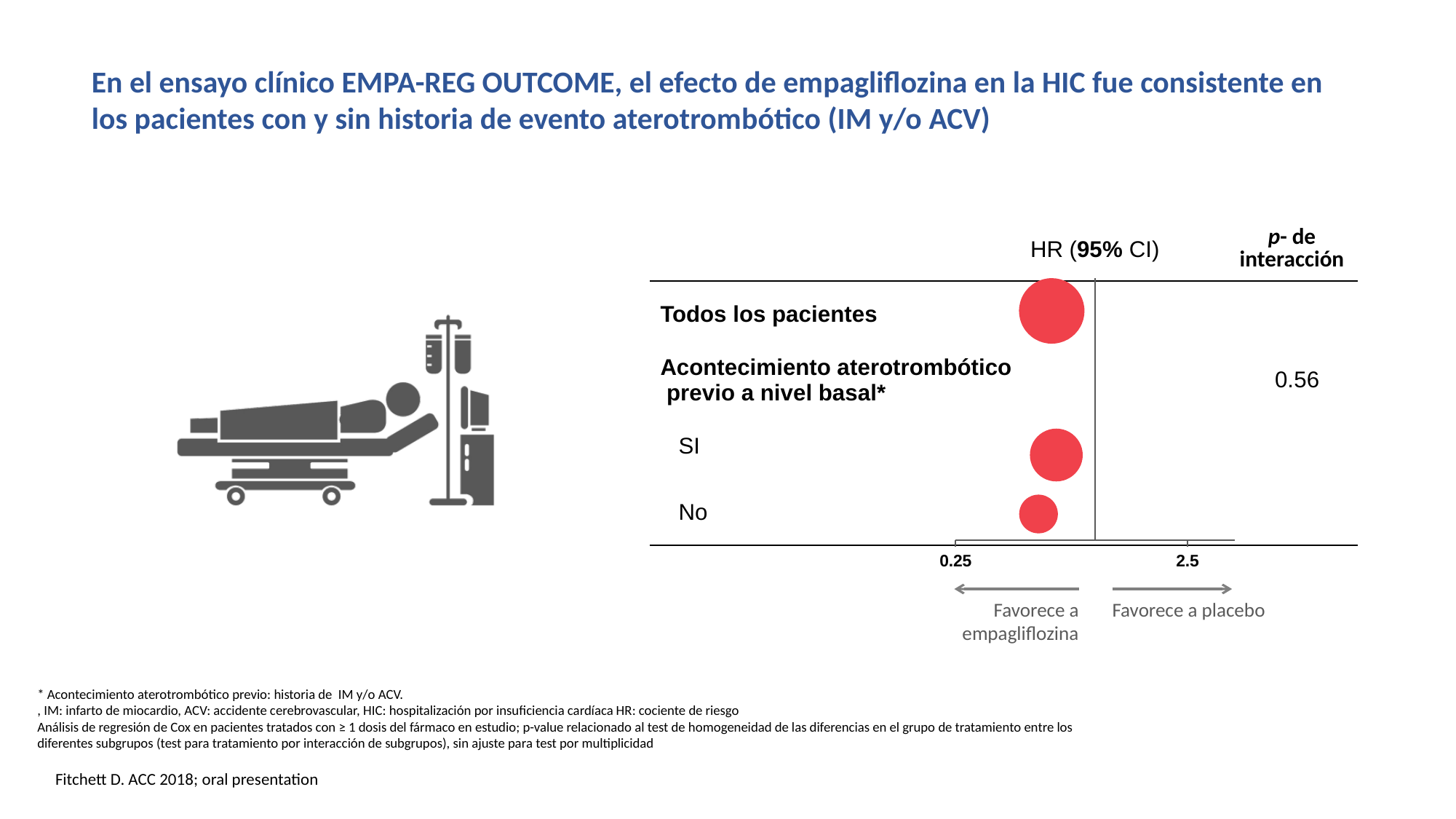
Which subgroup row has the smallest plotted marker? No What does the left side of the x axis favour according to the label? Favorece a empagliflozina On which side of the vertical reference line do all three points lie? Left (Favorece a empagliflozina) What is the p-value for interaction shown on the forest plot? 0.56 Is the hazard ratio for 'SI' greater or less than 0.25? greater What kind of chart is shown on the right of the slide? Forest plot Is the hazard ratio for 'Todos los pacientes' greater or less than 2.5? less How many subgroup rows (points) are plotted on the forest plot? 3 What are the two tick values printed on the x axis of the forest plot? 0.25 and 2.5 Is the hazard ratio for 'No' greater or less than 2.5? less What is the column header above the plotted points? HR (95% CI)